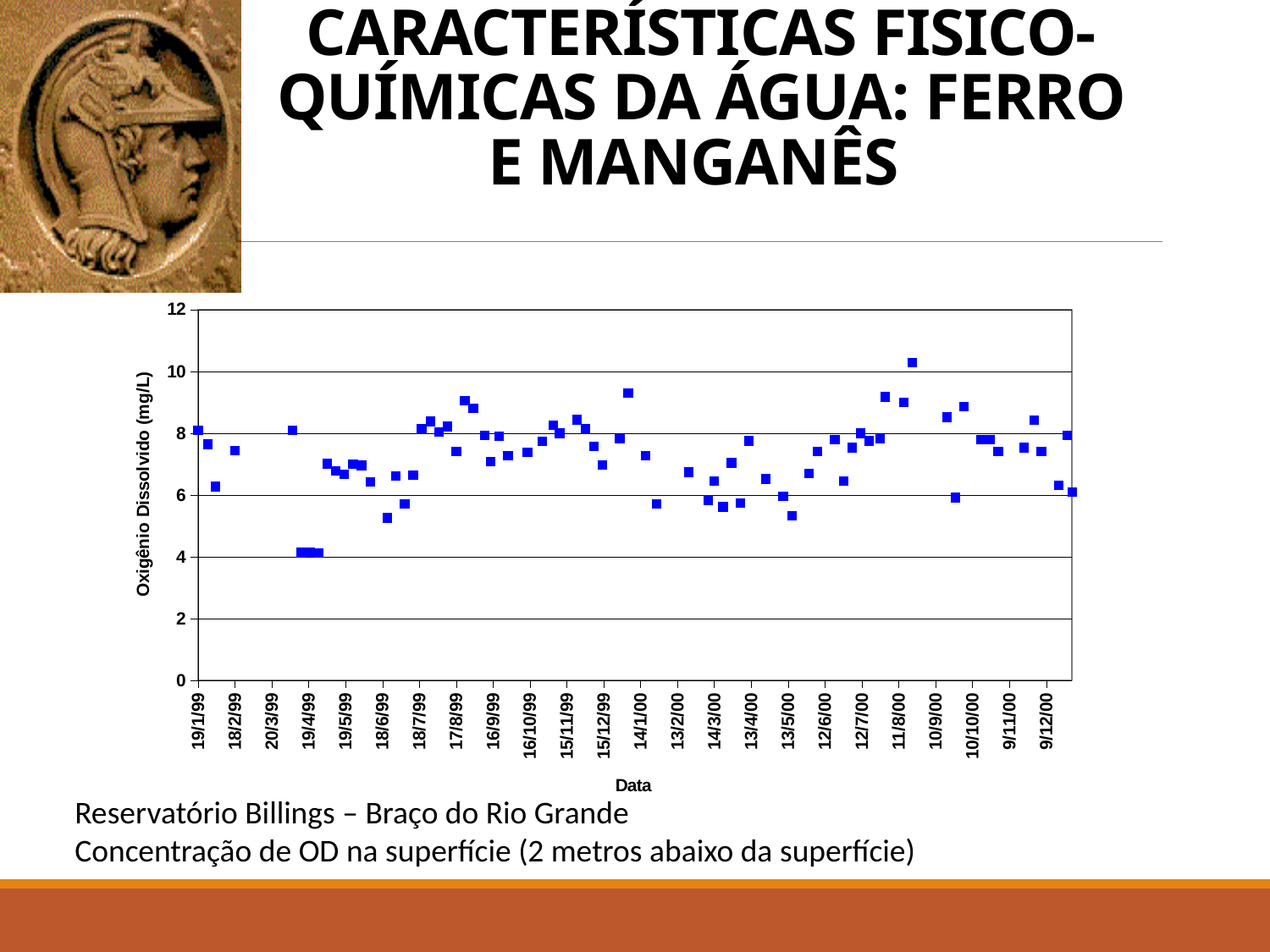
Around which x-axis date do the lowest plotted dissolved oxygen values occur? 19/4/99 Around which x-axis date does the highest plotted dissolved oxygen value occur? 11/8/00 Is the lowest dissolved oxygen value plotted on the chart greater or less than 6? less Is the highest dissolved oxygen value plotted on the chart greater or less than 10? greater Is the dissolved oxygen value plotted at 18/2/99 greater or less than 8? less What kind of chart is shown on the slide? scatter chart What is the title of the vertical axis of the chart? Oxigênio Dissolvido (mg/L) What is the title of the horizontal axis of the chart? Data